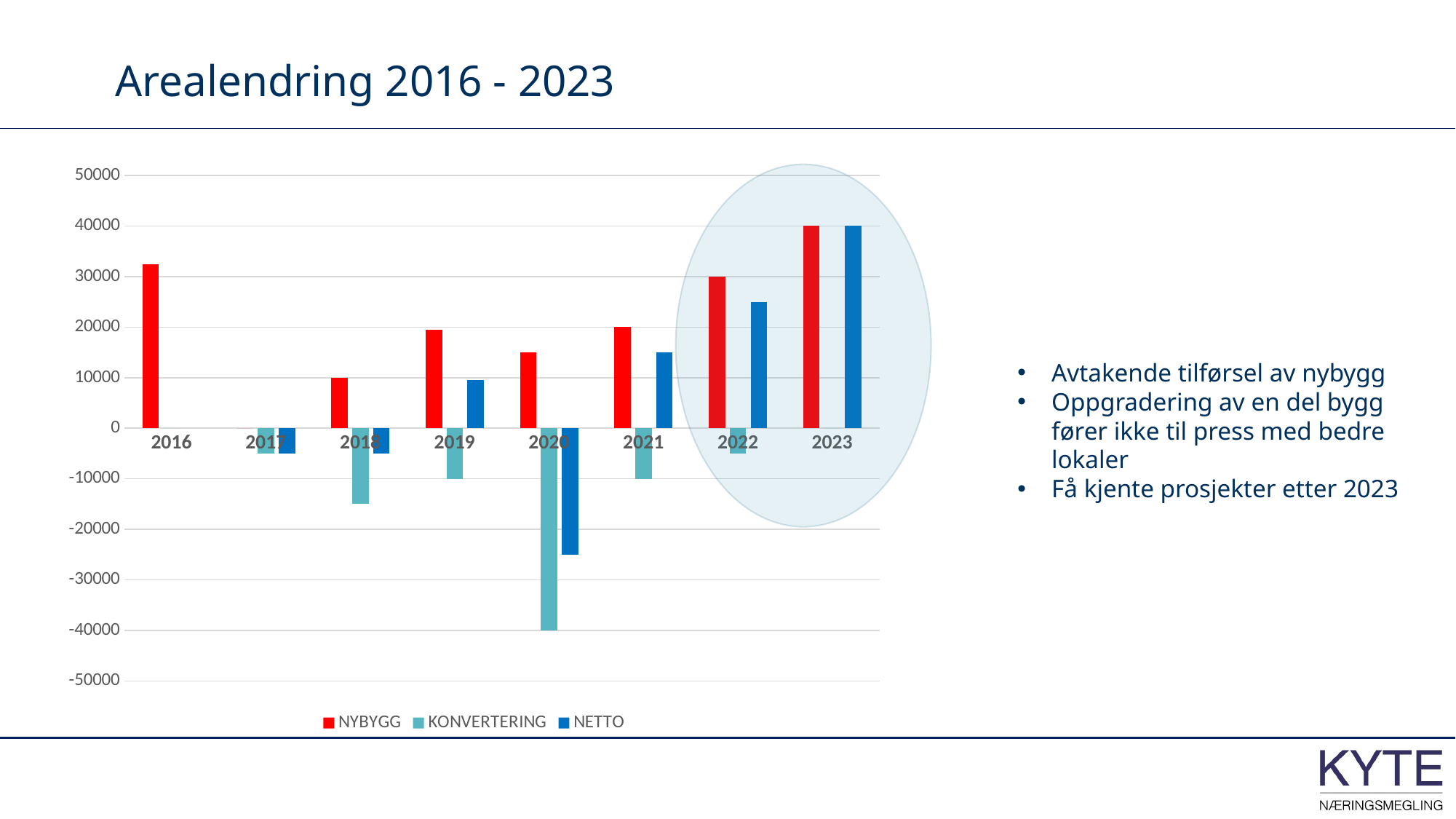
Does the NETTO value rise or fall from 2020 to 2023? rise Which year has the lowest KONVERTERING value? 2020 Which year has the highest NYBYGG value? 2023 How many years are shown on the x axis of the chart? 8 Is the NYBYGG value for 2016 greater or less than 30000? greater What are the three series listed in the legend? NYBYGG, KONVERTERING, NETTO What kind of chart is shown on the slide? bar chart How many series does the legend list? 3 Is the KONVERTERING value for 2018 greater or less than -10000? less Which is larger, the NYBYGG value for 2019 or the NYBYGG value for 2020? 2019 Which year has the lowest NETTO value? 2020 Is the NETTO value for 2022 greater or less than 20000? greater